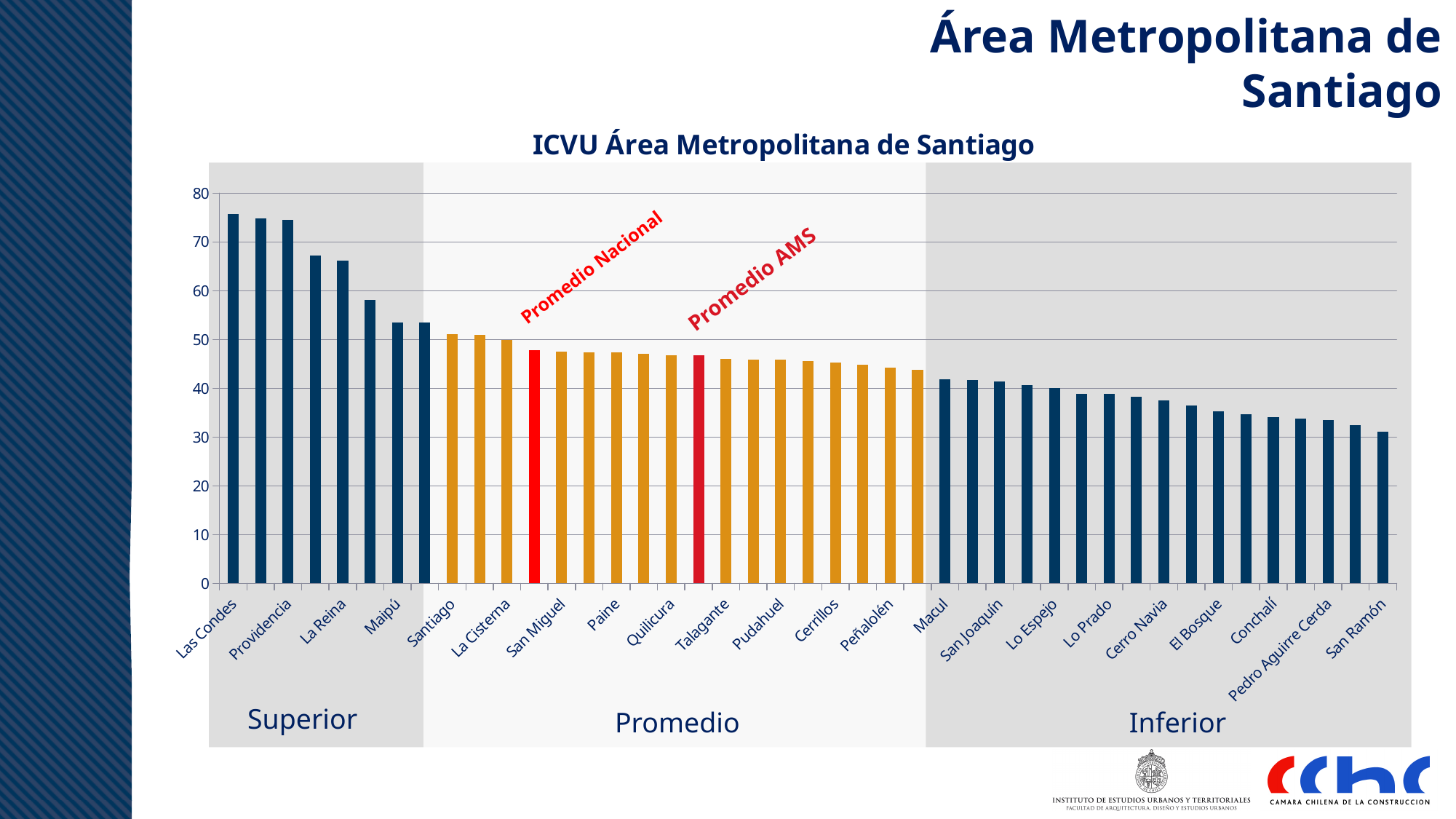
Is the value for La Reina greater or less than 60? greater Is the value for Peñalolén greater or less than 50? less Which comuna has the highest ICVU value in the chart? Las Condes What do the two red bars in the chart represent? Promedio Nacional and Promedio AMS Is the value for Las Condes greater or less than 70? greater Which has a larger value, Las Condes or Macul? Las Condes What is the title of the chart? ICVU Área Metropolitana de Santiago Which comuna has the lowest ICVU value in the chart? San Ramón Do the values rise or fall moving from left to right along the x axis? fall What type of chart is shown on the slide? bar chart